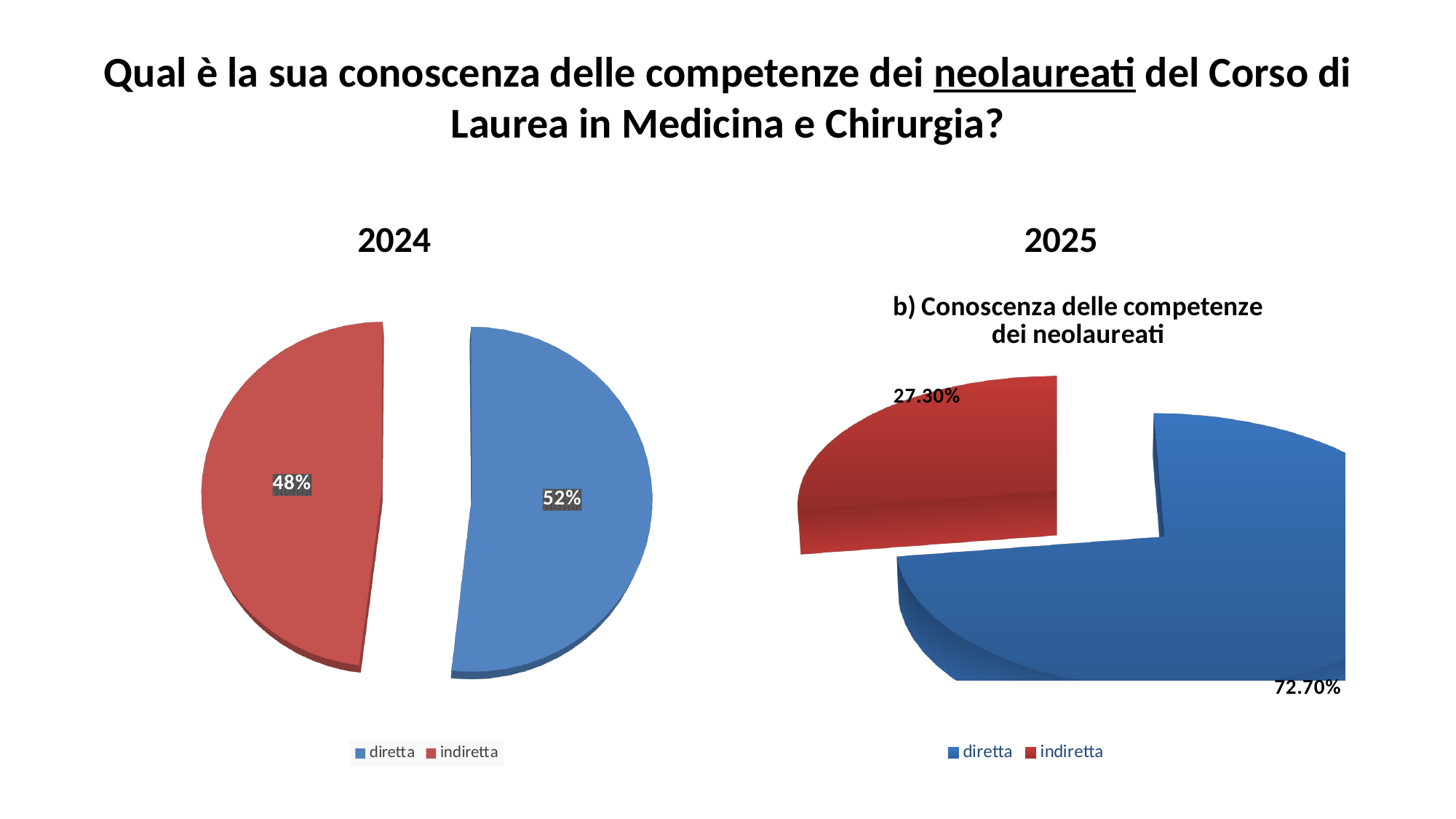
How many slices does the 2025 chart have? 2 In the 2024 chart, what is the value for diretta? 52% In the 2024 chart, what is the value for indiretta? 48% In the 2025 chart, what is the value for indiretta? 27.30% What is the title printed above the 2025 pie chart? b) Conoscenza delle competenze dei neolaureati In the 2025 chart, what is the difference between diretta and indiretta? 45.40% In the 2025 chart, which category has the largest slice? diretta In the 2025 chart, what is the value for diretta? 72.70% In the 2025 chart, which category has the smallest slice? indiretta In the 2024 chart, what is the difference between diretta and indiretta? 4% In the 2024 chart, which is larger, diretta or indiretta? diretta What kind of chart is the 2024 chart? pie chart